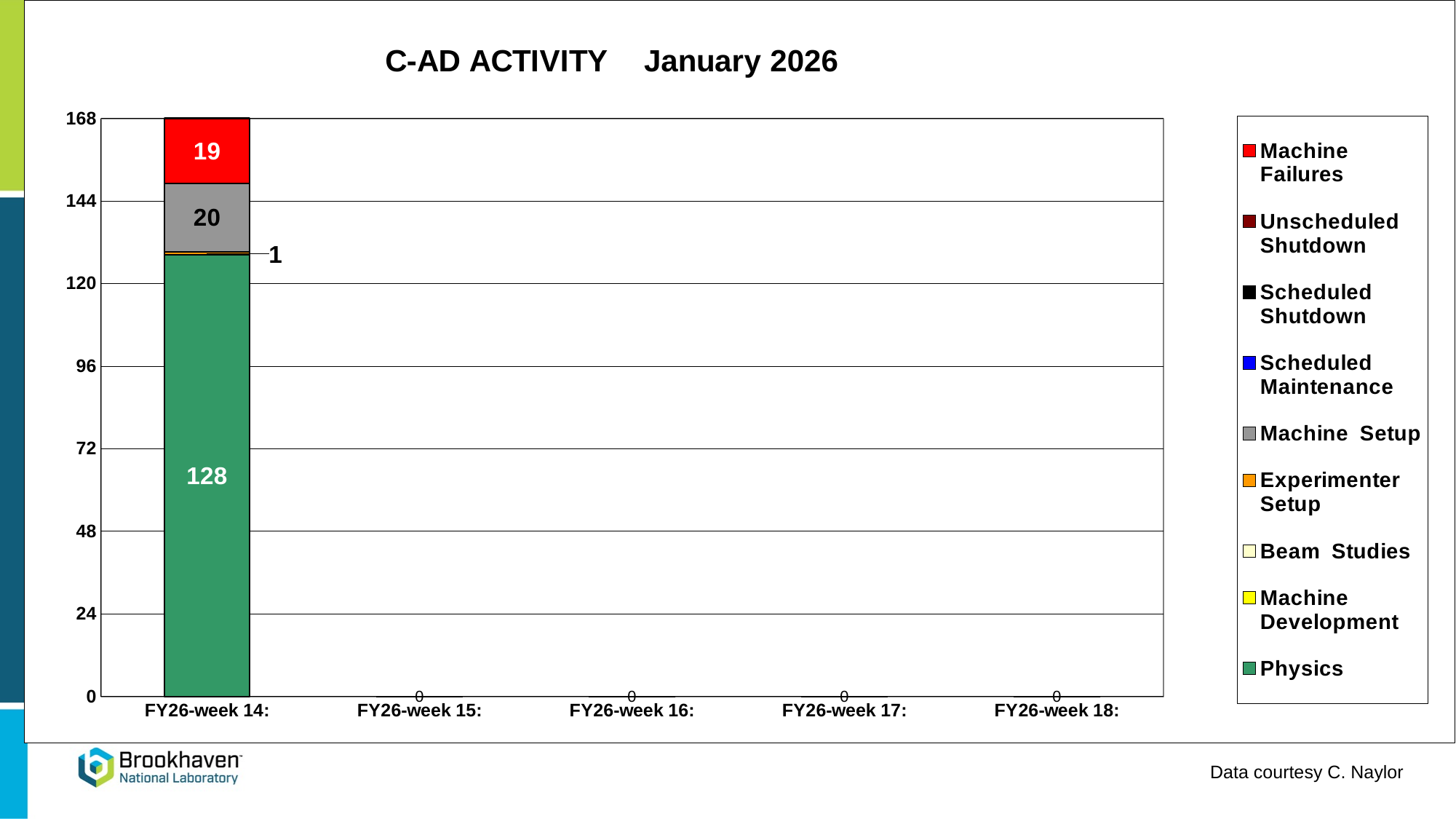
What is the difference between the Machine Setup value and the Machine Failures value for FY26-week 14? 1 Is the Physics value for FY26-week 14 greater or less than 120? greater What value is shown for FY26-week 15? 0 For FY26-week 14, which is larger: Machine Setup or Machine Failures? Machine Setup What is the Machine Setup value for FY26-week 14? 20 What is the Physics value for FY26-week 14? 128 Which week has the highest total on the chart? FY26-week 14: What is the difference between the Physics value and the Machine Setup value for FY26-week 14? 108 How many series does the legend list? 9 What kind of chart is shown on the slide? stacked bar chart What is the Machine Failures value for FY26-week 14? 19 How many week categories are shown on the x axis? 5